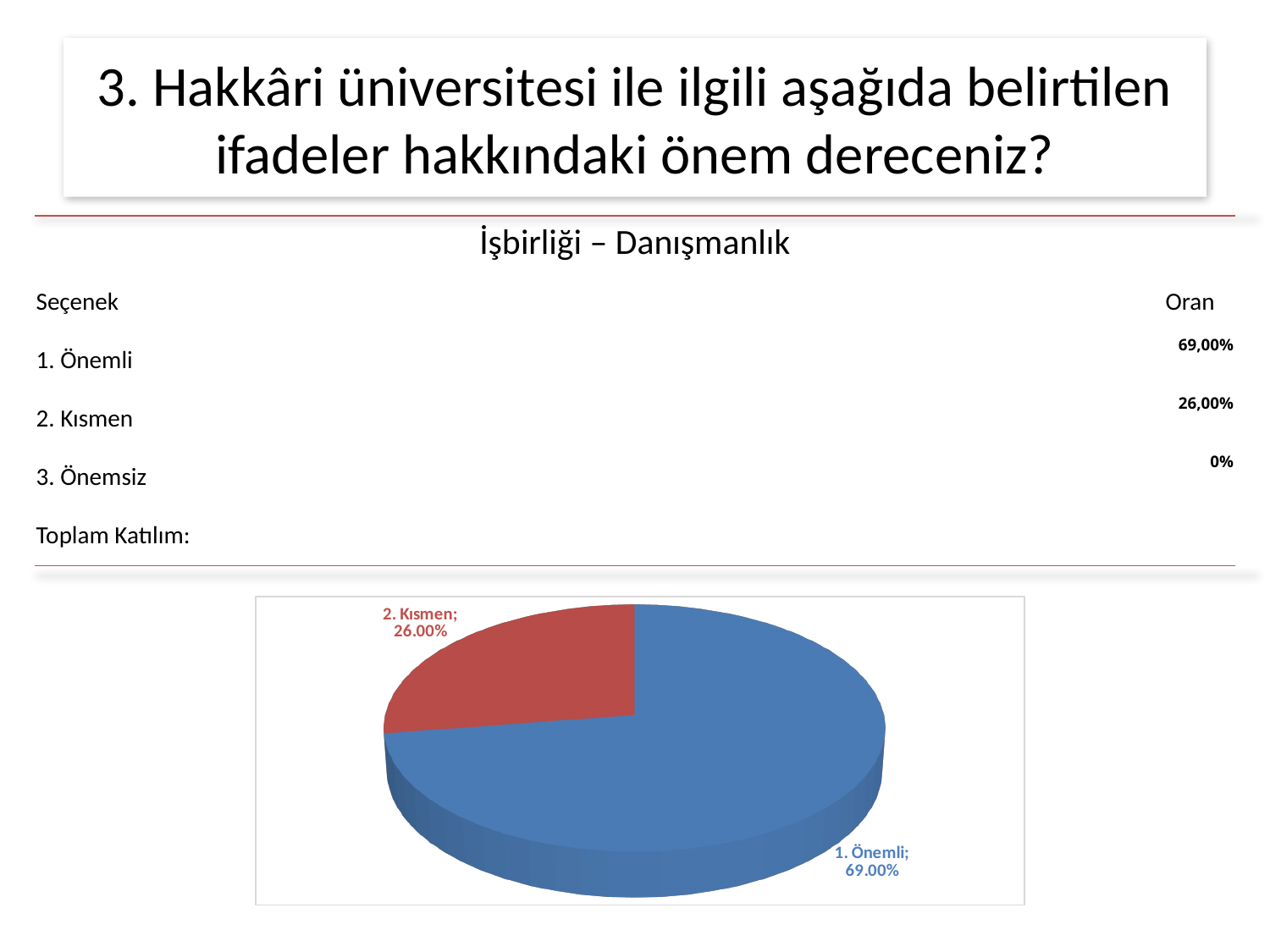
What share of the pie does the "2. Kısmen" slice represent? 26.00% What percentage does the pie chart show for "1. Önemli"? 69.00% What is the difference between the "1. Önemli" and "2. Kısmen" slices in the pie chart? 43.00% What percentage does the pie chart show for "2. Kısmen"? 26.00% What colour is the "1. Önemli" slice in the pie chart? blue What colour is the "2. Kısmen" slice in the pie chart? red Which slice is larger in the pie chart, "1. Önemli" or "2. Kısmen"? 1. Önemli How many slices are labeled on the pie chart? 2 What kind of chart is shown on the slide? pie chart Which labeled category has the smallest slice in the pie chart? 2. Kısmen Which category has the largest slice in the pie chart? 1. Önemli